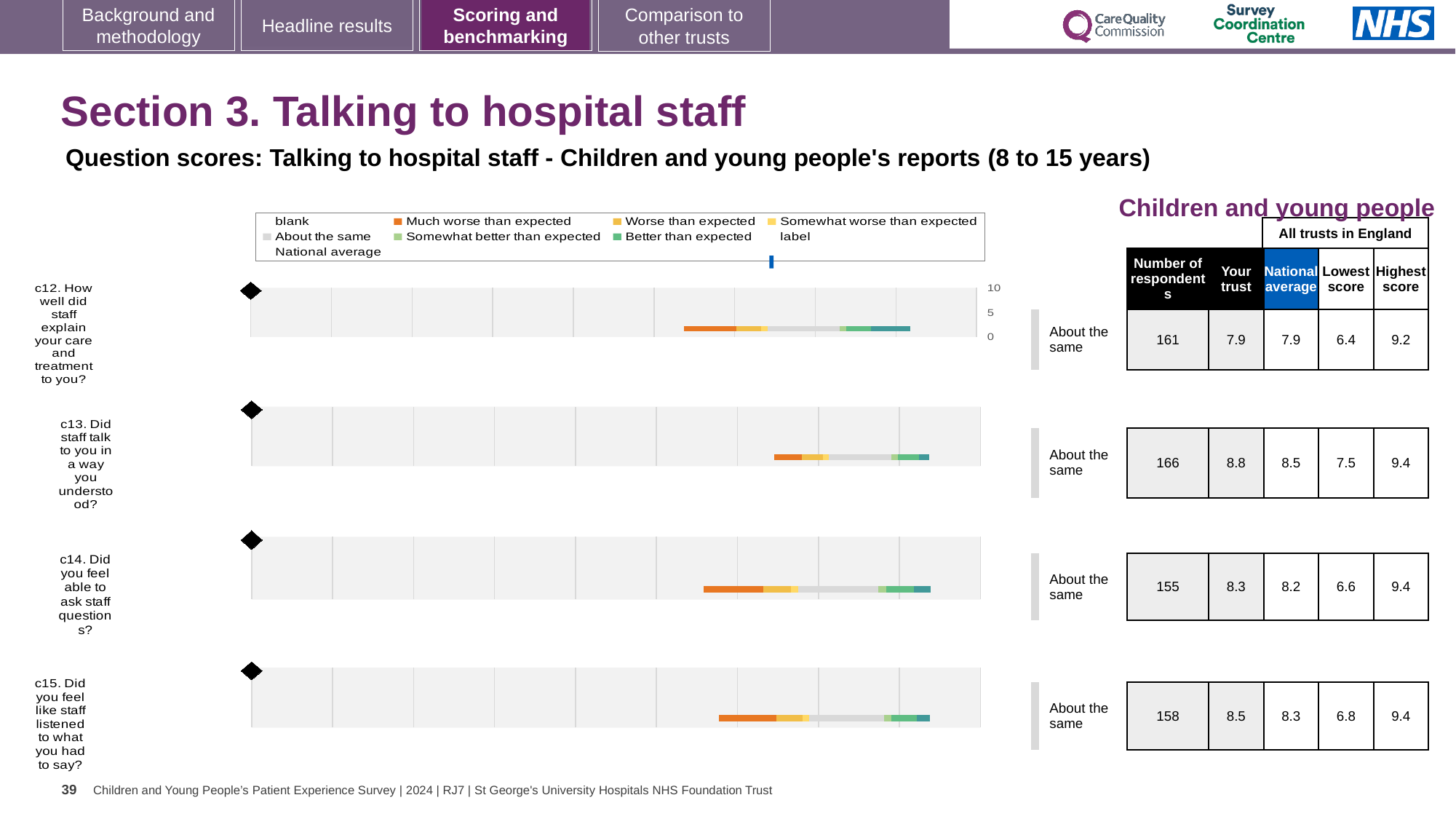
What is the 'Your trust' score for c13 'Did staff talk to you in a way you understood?' 8.8 Which question has the highest 'Your trust' score? c13. Did staff talk to you in a way you understood? For c12 'How well did staff explain your care and treatment to you?', how many respondents are shown? 161 Which colour does the legend use for 'Much worse than expected'? orange Which question has the lowest 'Lowest score' across all trusts in England? c12. How well did staff explain your care and treatment to you? For c13, what is the difference between the 'Your trust' score and the national average? 0.3 What kind of chart is used to show the question scores for c12 to c15? bar chart What is the national average for c15 'Did you feel like staff listened to what you had to say?' 8.3 For c14, is the 'Your trust' score or the national average larger? Your trust How many survey questions (c12 to c15) are plotted on the slide? 4 What is the highest value shown on the chart's score axis? 10 How many entries does the chart legend list? 9